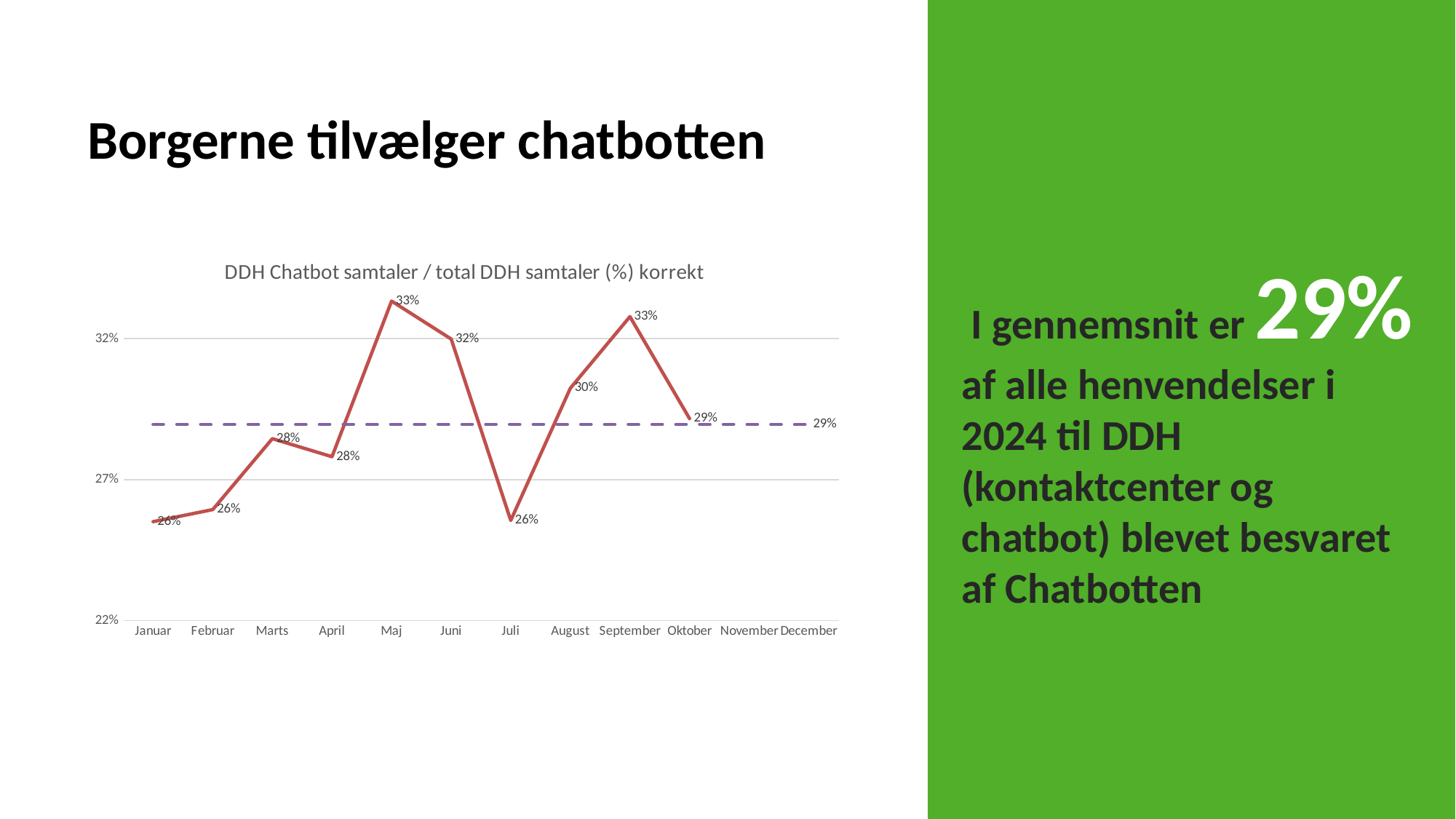
Do the values rise or fall from Juli to September? rise What is the value for Juli in the chart? 26% What kind of chart is shown on the slide? line chart What is the value for August in the chart? 30% Is the value for Maj greater or less than 32%? greater What is the value for Oktober in the chart? 29% What is the difference between the values for Maj and Juli? 7 percentage points What is the value for Marts in the chart? 28% What value does the dashed horizontal line in the chart mark? 29% How many months have a data point plotted on the line? 10 What is the value for Maj in the chart? 33% Which has the larger value, Juni or April? Juni